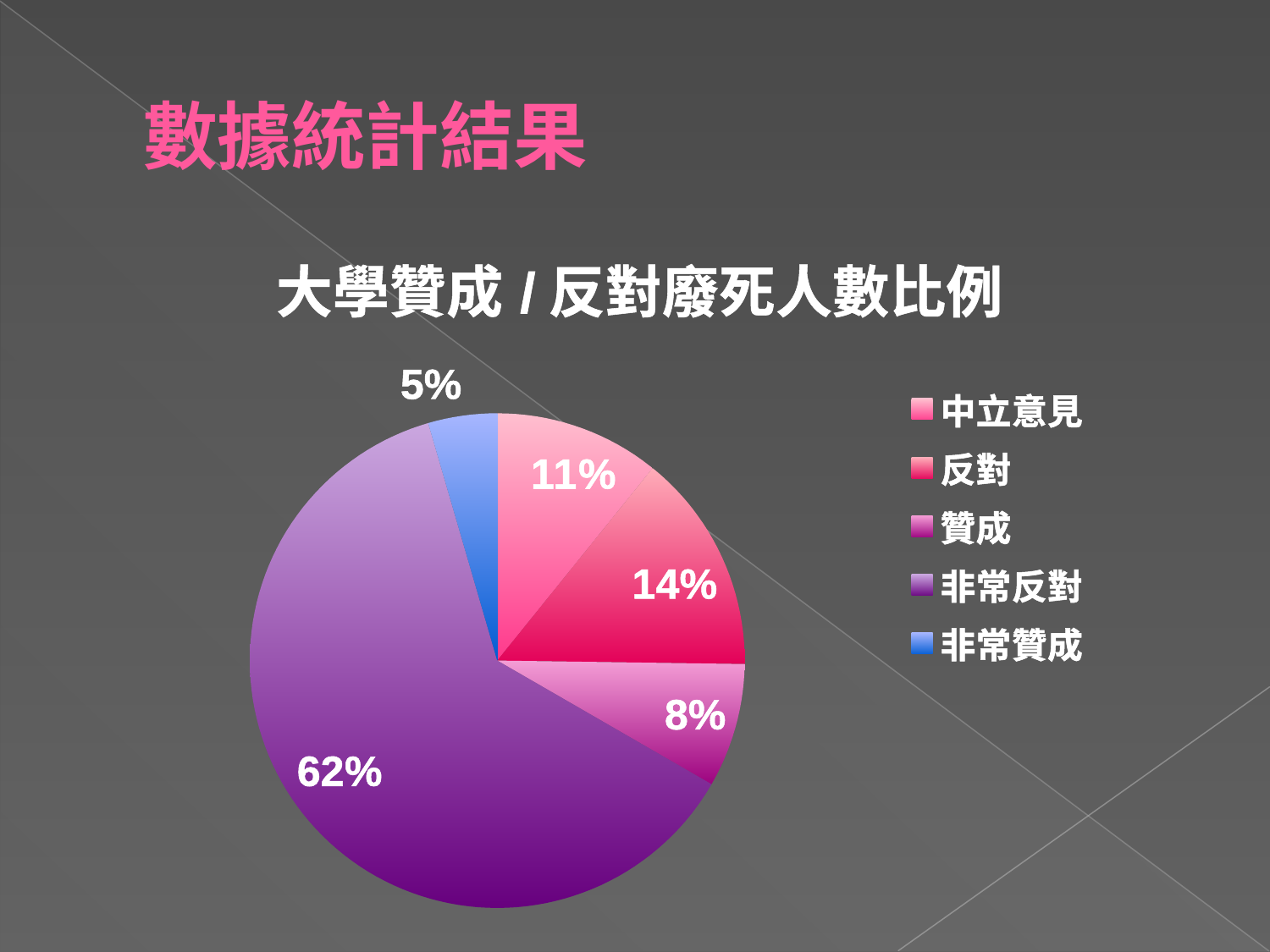
What share of the pie does 非常反對 take? 62% Which category has the largest slice of the pie? 非常反對 What share of the pie does 反對 take? 14% What kind of chart is shown on the slide? pie chart What is the title of the chart? 大學贊成 / 反對廢死人數比例 What share of the pie does 中立意見 take? 11% What is the difference in percentage points between the 非常反對 slice and the 反對 slice? 48 Which is larger, the slice for 反對 or the slice for 贊成? 反對 How many categories does the legend list? 5 Which category has the smallest slice of the pie? 非常贊成